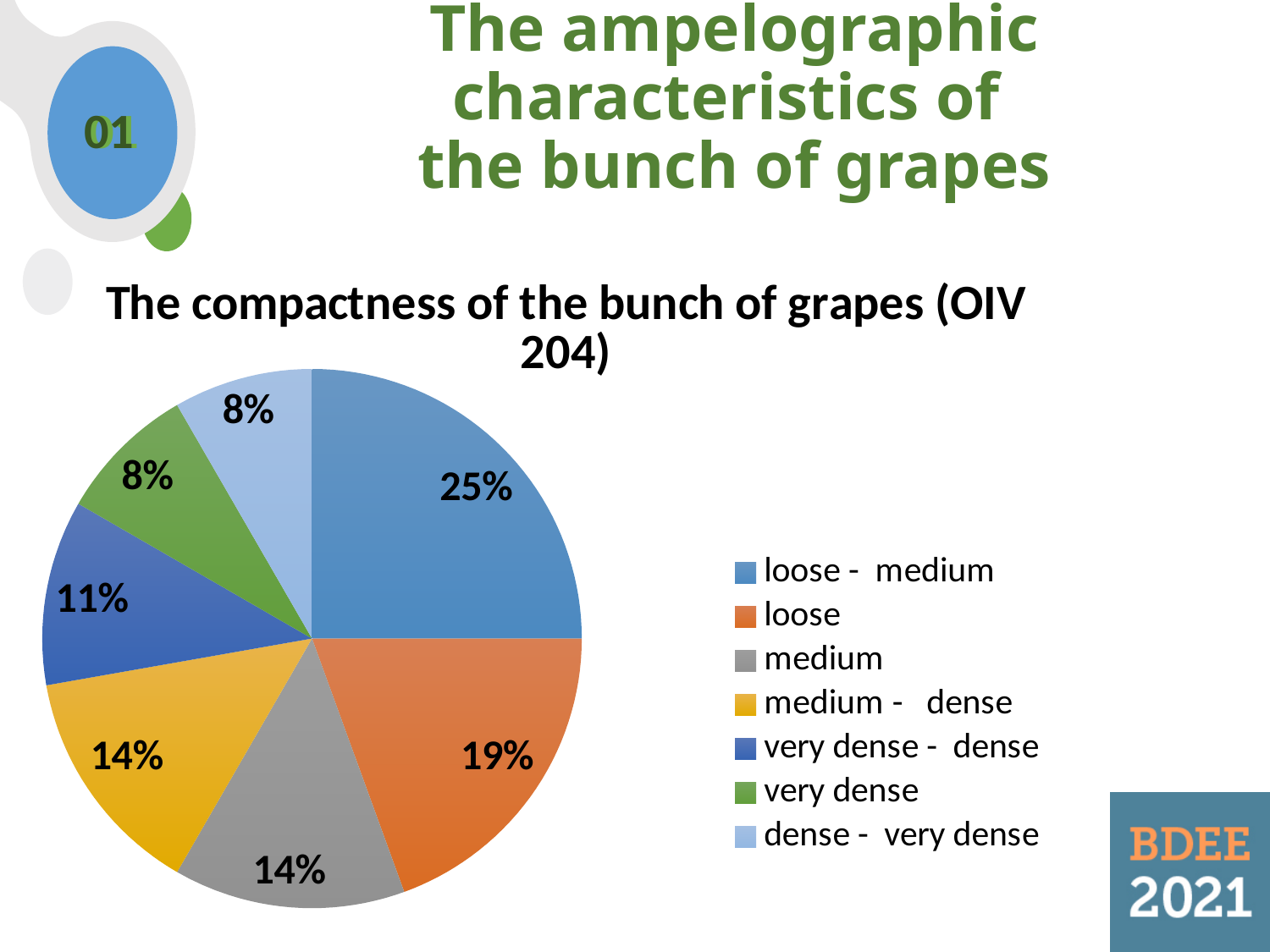
What share of the pie does the 'loose' category have? 19% What share of the pie does the 'medium - dense' category have? 14% What is the title of the chart? The compactness of the bunch of grapes (OIV 204) What share of the pie does the 'loose - medium' category have? 25% How many categories does the pie chart have? 7 What is the difference in percentage points between the 'loose - medium' and 'loose' shares? 6 Which category is shown in green in the legend? very dense Which has a larger share, 'loose' or 'medium'? loose What type of chart is shown on the slide? pie chart Which category has the largest share of the pie? loose - medium